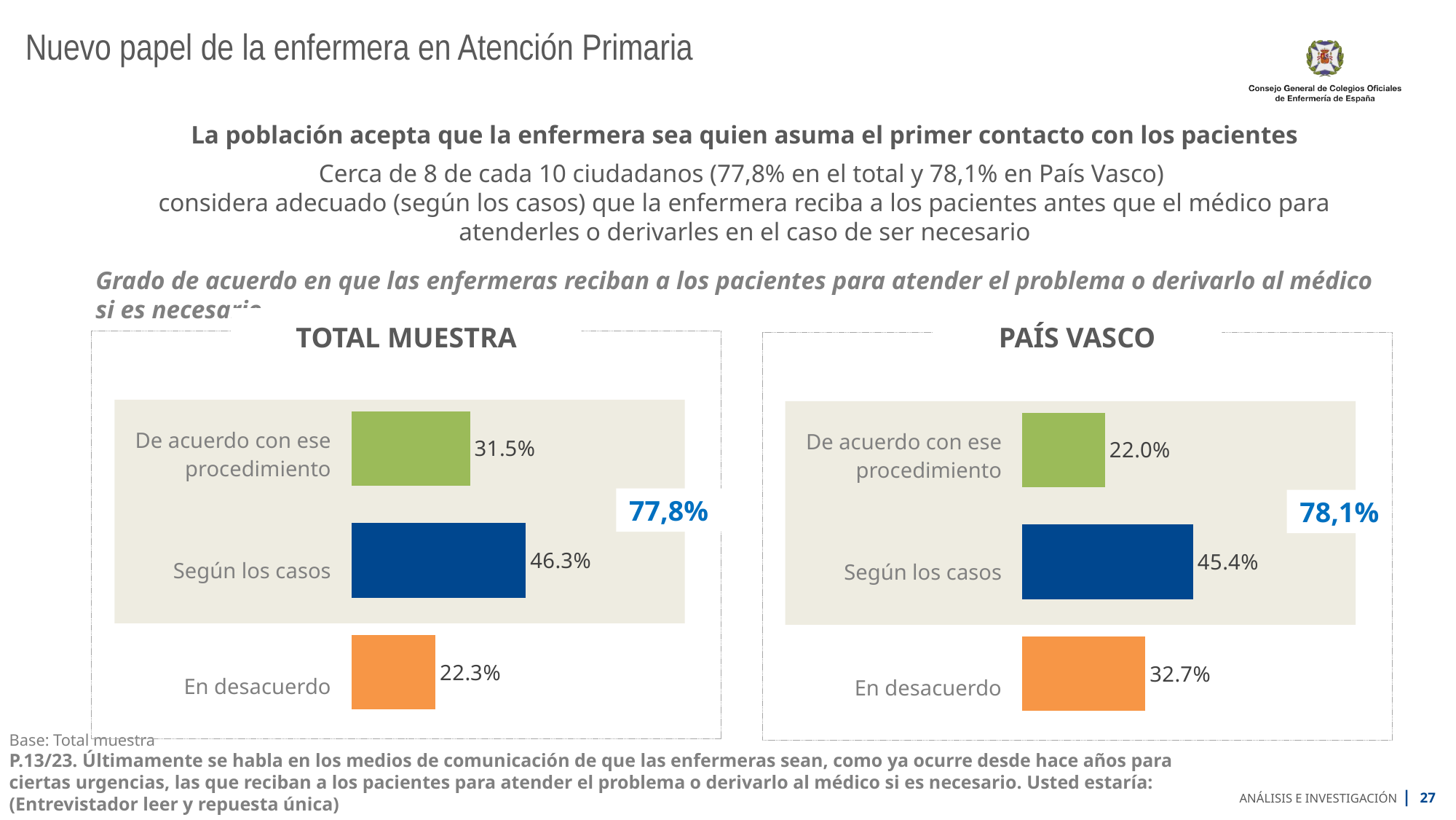
How many categories does the TOTAL MUESTRA chart show? 3 In the TOTAL MUESTRA chart, what is the value for "Según los casos"? 46.3% In the TOTAL MUESTRA chart, which category has the lowest value? En desacuerdo Is the value for "En desacuerdo" larger in the TOTAL MUESTRA chart or in the PAÍS VASCO chart? PAÍS VASCO In the PAÍS VASCO chart, which category has the lowest value? De acuerdo con ese procedimiento In the PAÍS VASCO chart, what combined percentage is highlighted in blue next to the first two bars? 78,1% In the TOTAL MUESTRA chart, what is the difference between "Según los casos" and "En desacuerdo"? 24.0% In the PAÍS VASCO chart, what is the difference between "En desacuerdo" and "De acuerdo con ese procedimiento"? 10.7% In the TOTAL MUESTRA chart, what is the value for "De acuerdo con ese procedimiento"? 31.5% What kind of chart is the PAÍS VASCO chart? Bar chart In the PAÍS VASCO chart, which category has the highest value? Según los casos In the PAÍS VASCO chart, what is the value for "En desacuerdo"? 32.7%